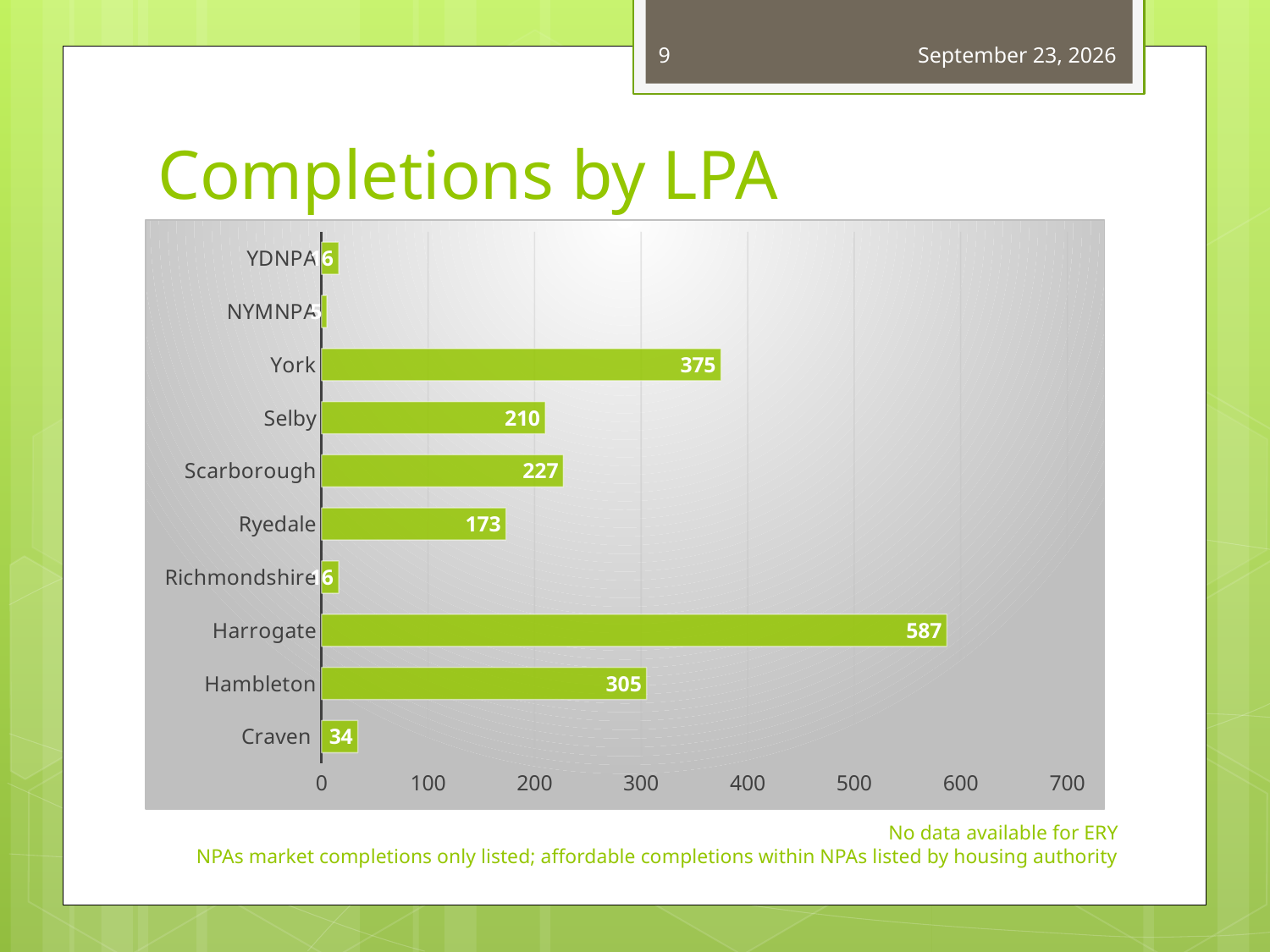
Which has a larger value, Hambleton or Selby? Hambleton What is the value for Craven? 34 How many LPAs are listed on the chart? 10 What is the title of the chart? Completions by LPA What is the value for Ryedale? 173 What is the difference between the values for Scarborough and Selby? 17 How many completions are shown for Harrogate? 587 What type of chart is shown on the slide? bar chart What is the difference between the values for Harrogate and York? 212 What is the value for York? 375 Which LPA has the highest number of completions? Harrogate Is the value for Hambleton greater or less than 300? greater